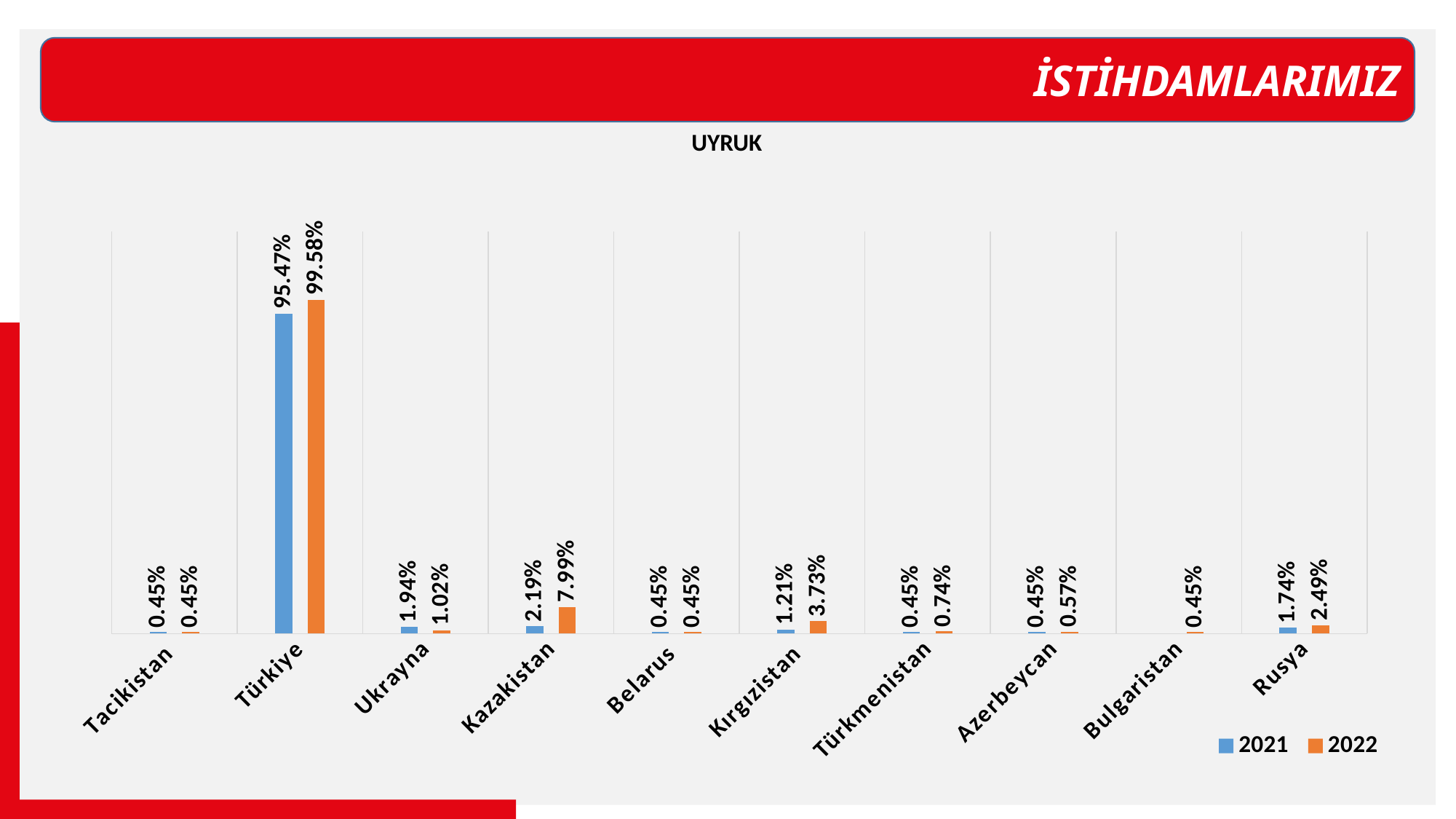
Which has the larger 2022 value, Kırgızistan or Rusya? Kırgızistan What is the difference between the 2022 and 2021 values for Türkiye? 4.11 percentage points Which category has the highest value in 2021? Türkiye What is the value for Kırgızistan in 2021? 1.21% What kind of chart is shown on the slide? Bar chart What is the difference between the 2022 and 2021 values for Kazakistan? 5.80 percentage points For Ukrayna, which year has the larger value, 2021 or 2022? 2021 What is the value for Türkiye in 2022? 99.58% What is the value for Kazakistan in 2022? 7.99% How many series does the legend list? 2 What is the value for Rusya in 2022? 2.49% How many categories are shown on the x axis? 10